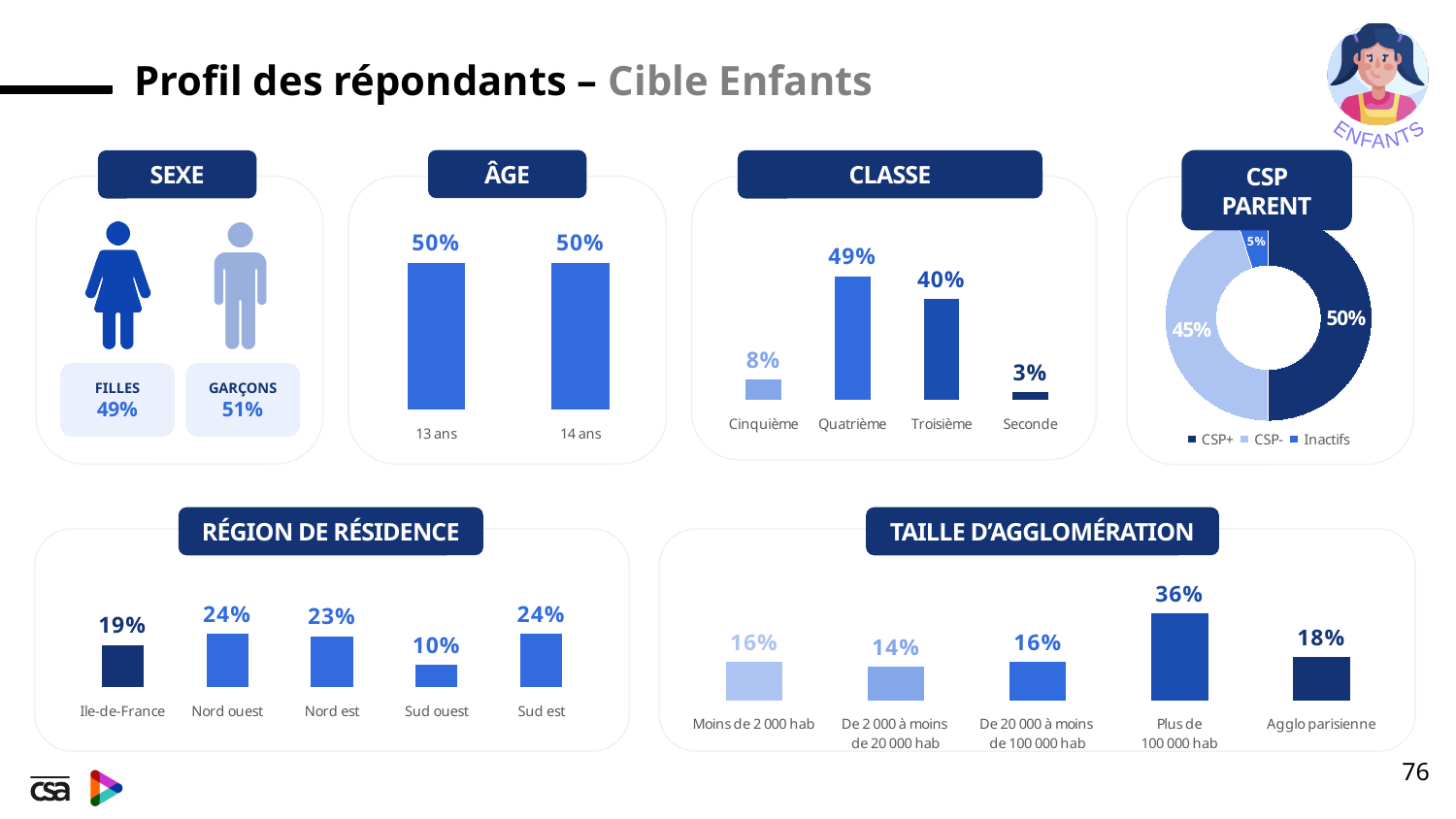
In the CLASSE chart, what is the value for Quatrième? 49% In the TAILLE D'AGGLOMÉRATION chart, which category has the highest value? Plus de 100 000 hab In the CSP PARENT chart, what share of the donut is CSP+? 50% What kind of chart is the CSP PARENT chart? Donut chart In the TAILLE D'AGGLOMÉRATION chart, which is larger: Agglo parisienne or De 2 000 à moins de 20 000 hab? Agglo parisienne In the CLASSE chart, what is the difference between Troisième and Cinquième? 32% In the ÂGE chart, what is the value for 13 ans? 50% How many series does the legend of the CSP PARENT chart list? 3 In the RÉGION DE RÉSIDENCE chart, what is the value for Sud ouest? 10% How many categories are shown in the RÉGION DE RÉSIDENCE chart? 5 What kind of chart is the CLASSE chart? Bar chart In the CLASSE chart, which category has the lowest value? Seconde